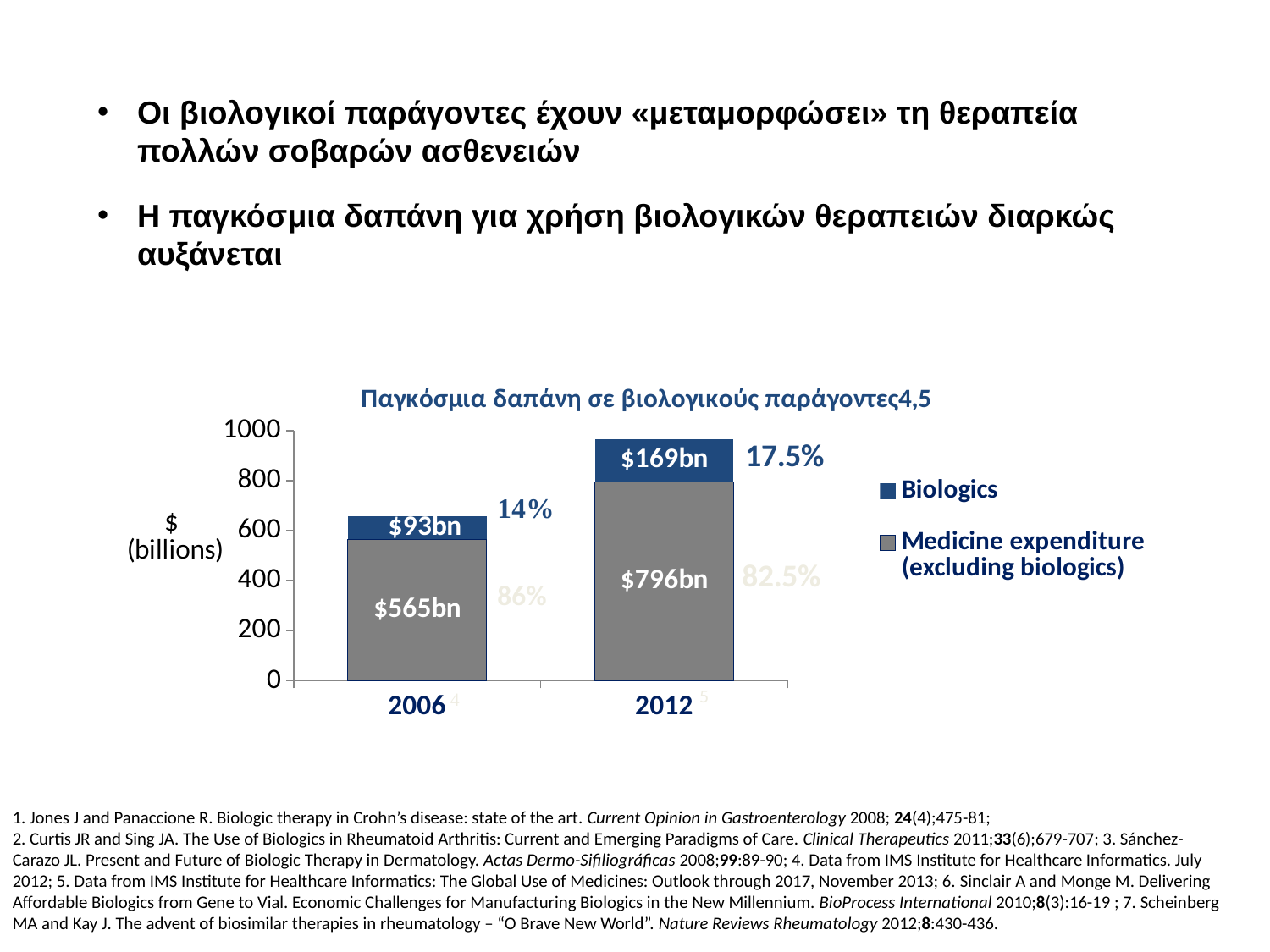
What is the total of the stacked bar for 2012? $965bn What is the Medicine expenditure (excluding biologics) value for 2006? $565bn What percentage share of the 2012 bar is labelled for Biologics? 17.5% What is the total of the stacked bar for 2006? $658bn What is the Medicine expenditure (excluding biologics) value for 2012? $796bn What is the Biologics value for 2006? $93bn What percentage share of the 2006 bar is labelled for Medicine expenditure (excluding biologics)? 86% What kind of chart is shown on the slide? Stacked bar chart What is the Biologics value for 2012? $169bn What is the difference between the Biologics values for 2012 and 2006? $76bn Which year has the larger Medicine expenditure (excluding biologics) value, 2006 or 2012? 2012 How many series does the legend list? 2